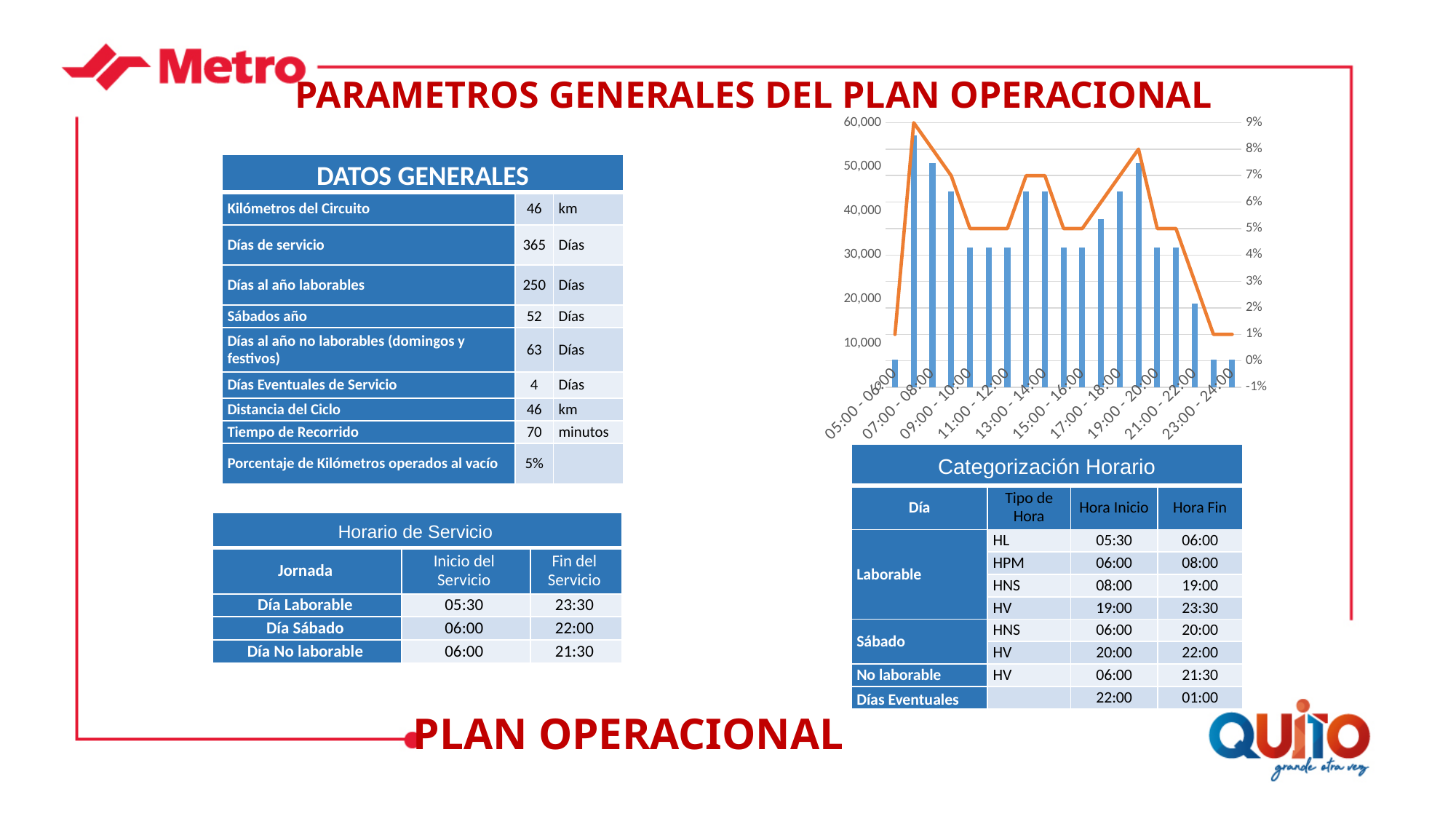
Is the bar value for 23:00 - 24:00 greater or less than 10,000? less Is the bar value for 07:00 - 08:00 greater or less than 40,000? greater Which has the taller bar, 07:00 - 08:00 or 09:00 - 10:00? 07:00 - 08:00 Is the line value for 23:00 - 24:00 greater or less than 2%? less What colour is the line series in the chart? Orange What is the highest value shown on the left vertical axis of the chart? 60,000 Does the orange line rise or fall from 19:00 - 20:00 to 23:00 - 24:00? fall What kind of chart is shown on the slide? A combined bar and line chart Which has the taller bar, 13:00 - 14:00 or 23:00 - 24:00? 13:00 - 14:00